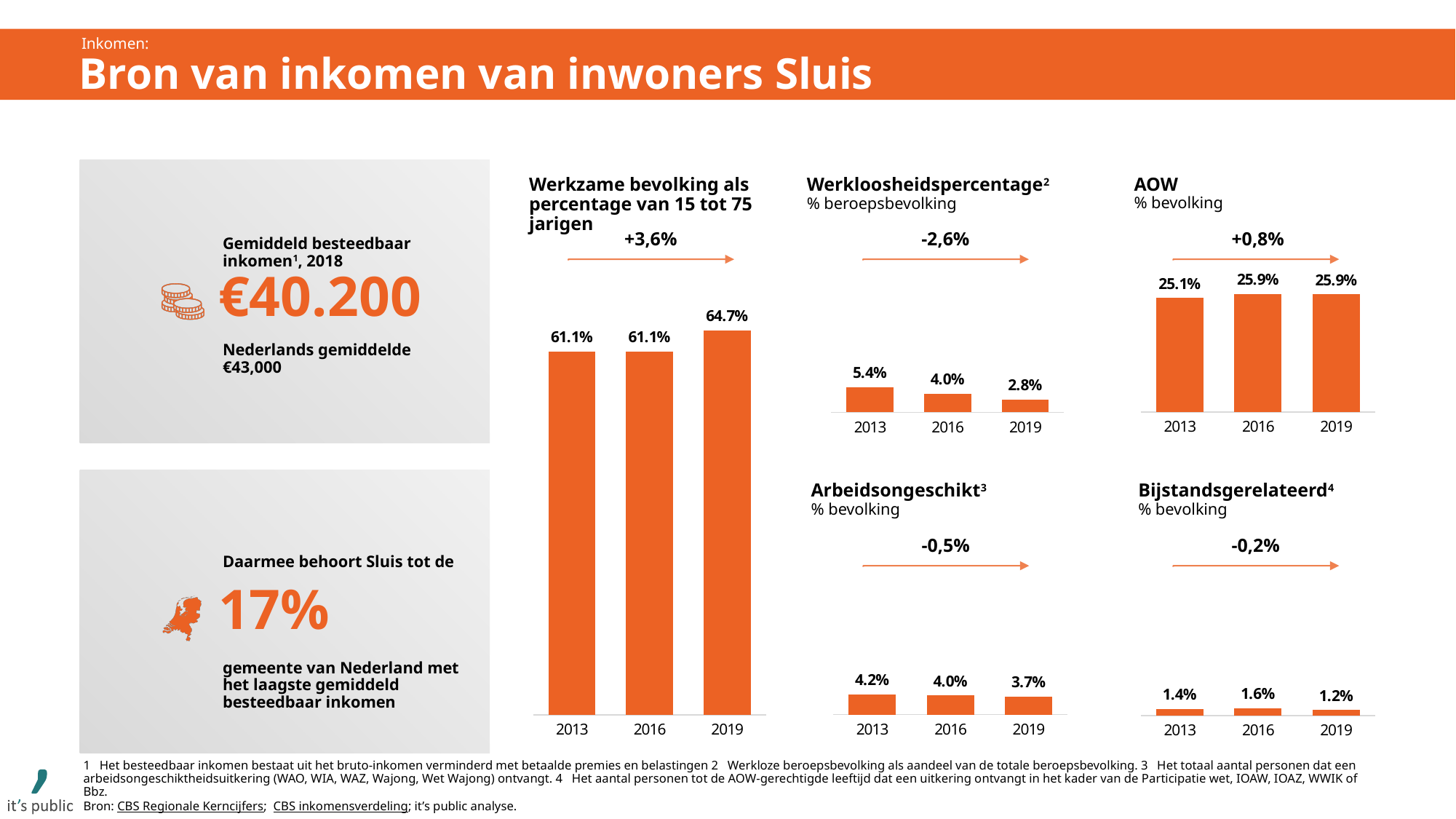
In the 'Bijstandsgerelateerd' chart, which year has the highest value? 2016 In the 'Werkzame bevolking als percentage van 15 tot 75 jarigen' chart, what is the value for 2019? 64.7% In the 'Werkloosheidspercentage' chart, do the values rise or fall from 2013 to 2019? Fall In the 'AOW' chart, what is the value for 2016? 25.9% How many bars does the 'AOW' chart show? 3 In the 'Bijstandsgerelateerd' chart, is the value for 2013 or 2019 larger? 2013 In the 'Arbeidsongeschikt' chart, what is the value for 2019? 3.7% In the 'Werkloosheidspercentage' chart, which year has the lowest value? 2019 In the 'Werkloosheidspercentage' chart, what is the value for 2013? 5.4% What type of chart is used for 'Arbeidsongeschikt'? Bar chart In the 'Werkloosheidspercentage' chart, what is the difference between the 2013 and 2019 values? 2.6% How many bar charts are shown on the slide? 5